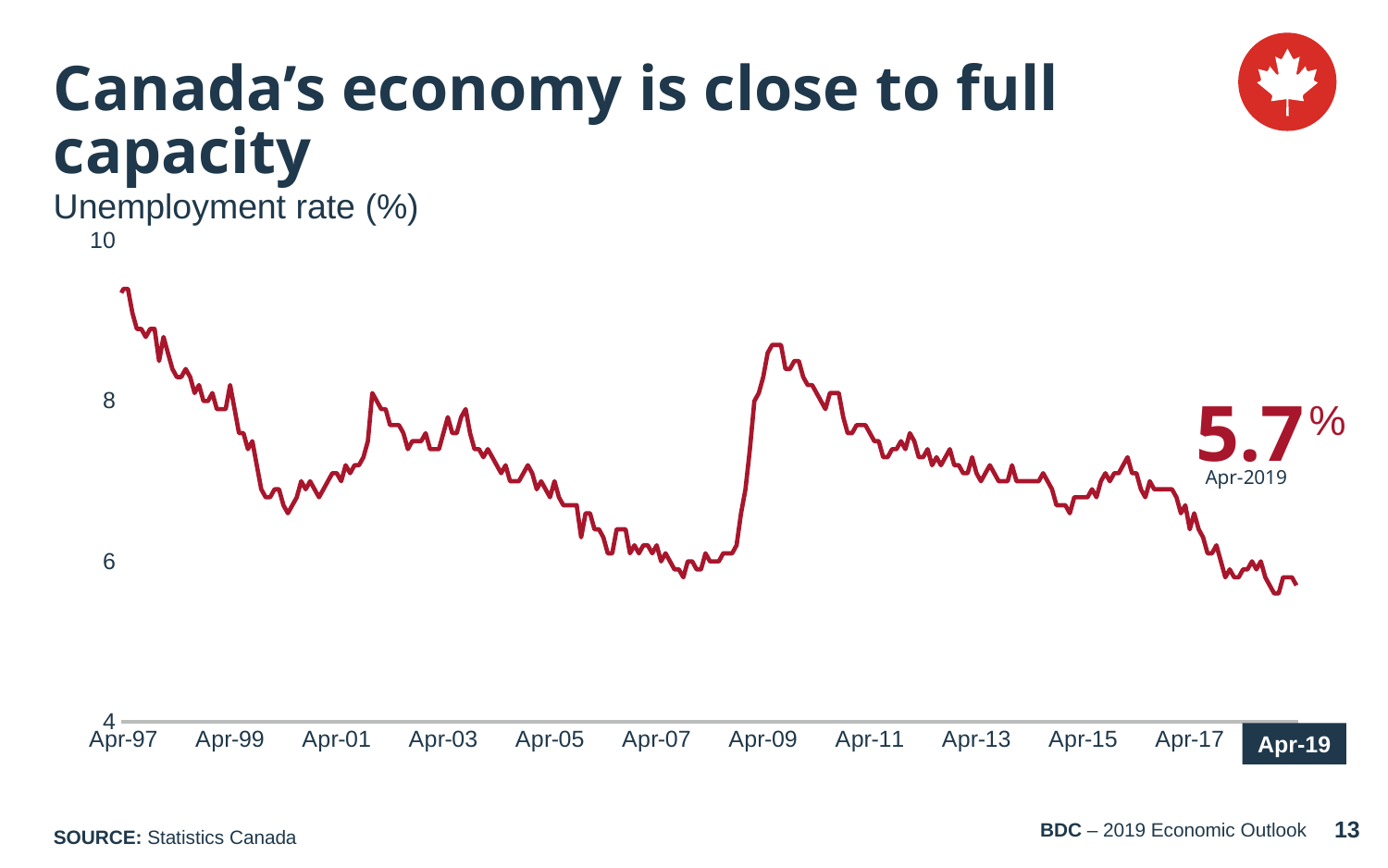
Is the unemployment rate at Apr-97 greater or less than 8? greater What is the title of the slide containing the chart? Canada's economy is close to full capacity Overall, does the unemployment rate rise or fall from Apr-97 to Apr-19? fall Is the unemployment rate at Apr-15 greater or less than 8? less What is the source of the chart data? Statistics Canada Which is higher: the unemployment rate at Apr-97 or the peak around 2009? Apr-97 Is the unemployment rate at Apr-13 greater or less than 8? less What is the unemployment rate shown for Apr-2019? 5.7% How many date labels are shown on the x axis? 12 What kind of chart is used to show the unemployment rate? line chart Which is larger: the unemployment rate at Apr-97 or at Apr-19? Apr-97